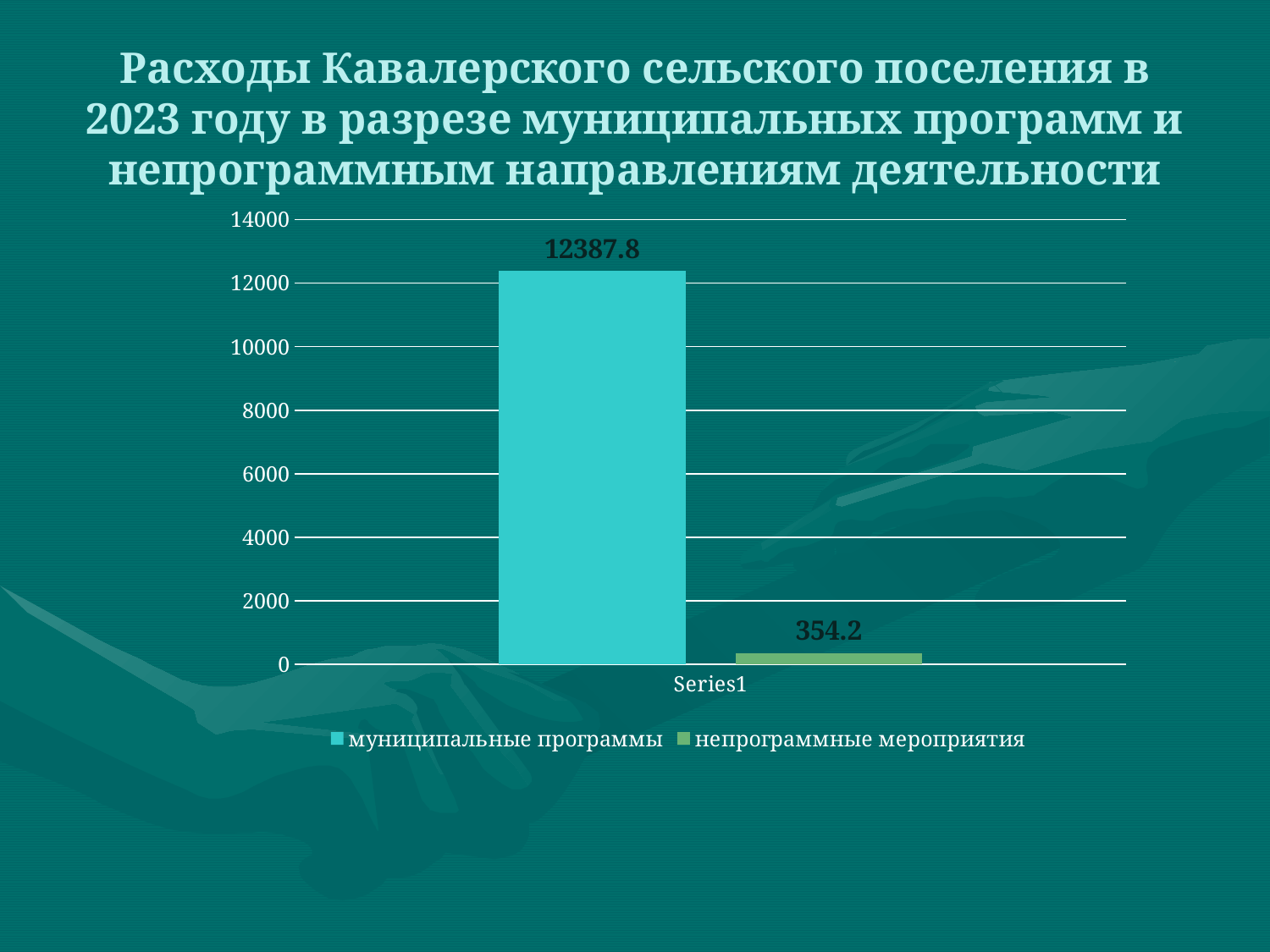
What is the value for непрограммные мероприятия? 354.2 Which series has the highest value? муниципальные программы How many series does the legend list? 2 What is the difference between the values for муниципальные программы and непрограммные мероприятия? 12033.6 Which series has the lowest value? непрограммные мероприятия Is the value for непрограммные мероприятия greater or less than 2000? less Which is larger, муниципальные программы or непрограммные мероприятия? муниципальные программы What kind of chart is shown on the slide? bar chart What is the value for муниципальные программы? 12387.8 What is the category label shown on the x axis? Series1 What is the highest value shown on the vertical axis? 14000 Is the value for муниципальные программы greater or less than 12000? greater